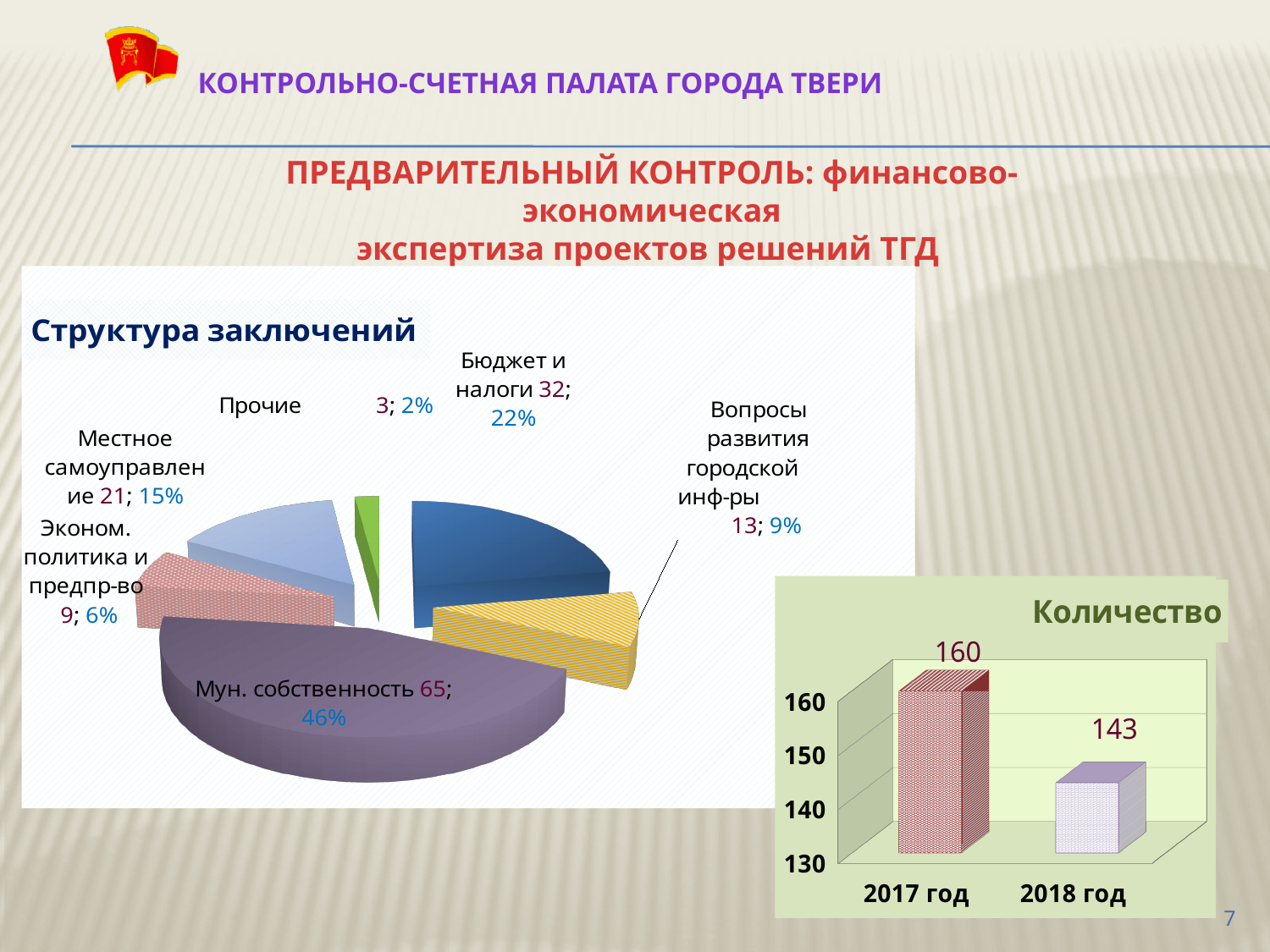
In the chart titled "Структура заключений", what share of the pie does "Бюджет и налоги" take? 22% In the chart titled "Структура заключений", what is the value for "Мун. собственность"? 65 In the chart titled "Структура заключений", what share of the pie does "Эконом. политика и предпр-во" take? 6% What kind of chart is the chart titled "Количество"? bar chart In the chart titled "Количество", what is the difference between the values for "2017 год" and "2018 год"? 17 In the chart titled "Структура заключений", what is the difference between the values for "Бюджет и налоги" and "Вопросы развития городской инф-ры"? 19 In the chart titled "Структура заключений", what is the value for "Местное самоуправление"? 21 In the chart titled "Структура заключений", how many categories are shown? 6 In the chart titled "Структура заключений", which category has the largest slice? Мун. собственность In the chart titled "Количество", do the values rise or fall from 2017 год to 2018 год? fall In the chart titled "Структура заключений", which category has the smallest slice? Прочие In the chart titled "Количество", what is the value for "2017 год"? 160